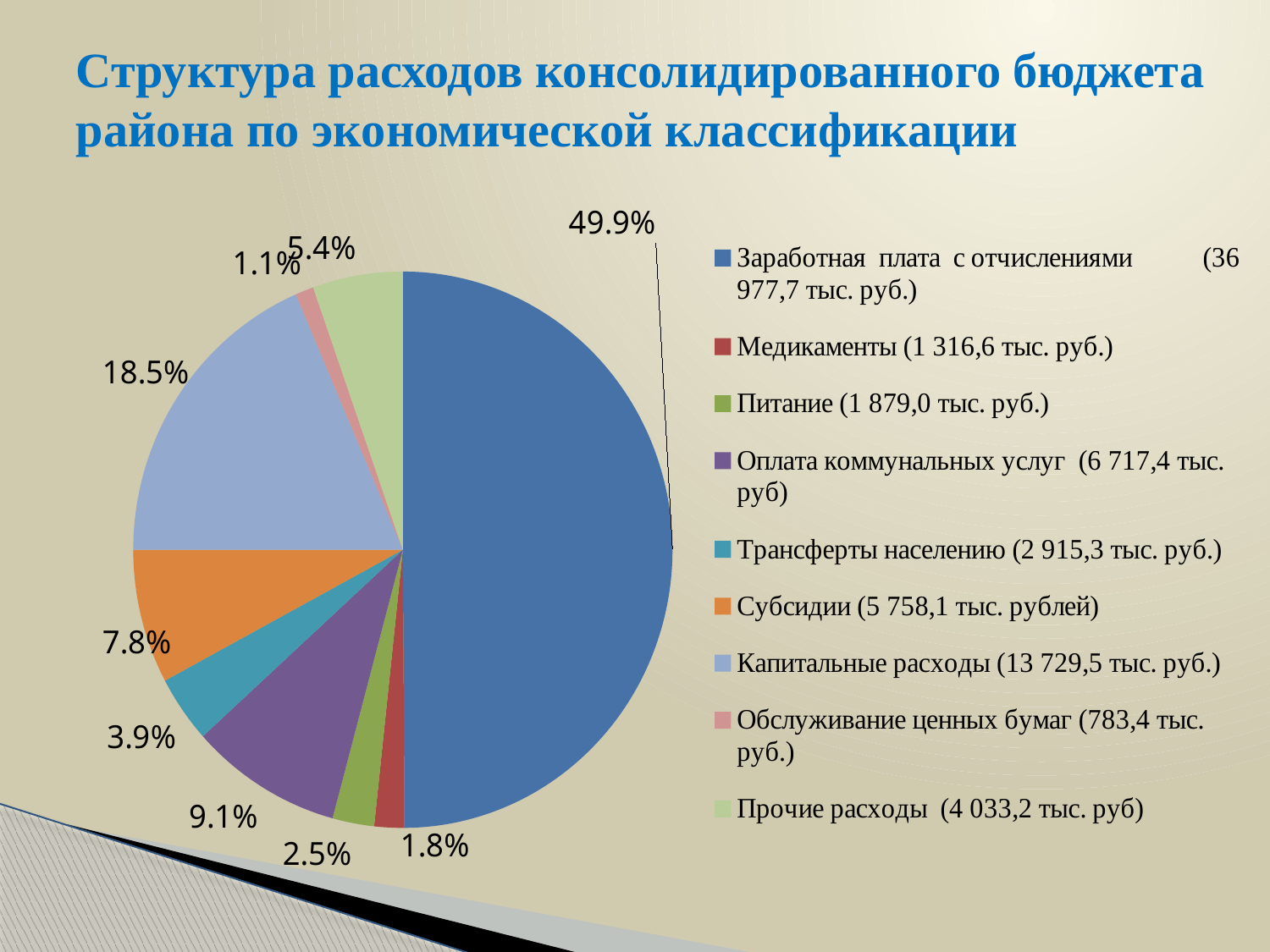
What share of the pie does "Заработная плата с отчислениями" take? 49.9% What share of the pie does "Капитальные расходы" take? 18.5% What share of the pie does "Обслуживание ценных бумаг" take? 1.1% Which category has the smallest share of the pie? Обслуживание ценных бумаг Which category has the largest share of the pie? Заработная плата с отчислениями How many slices does the pie chart have? 9 What kind of chart is shown on the slide? pie chart What is the difference in percentage points between the shares of "Капитальные расходы" and "Субсидии"? 10.7 What amount in thousand rubles is given in the legend for "Медикаменты"? 1 316,6 тыс. руб. Which has a larger share, "Трансферты населению" or "Прочие расходы"? Прочие расходы